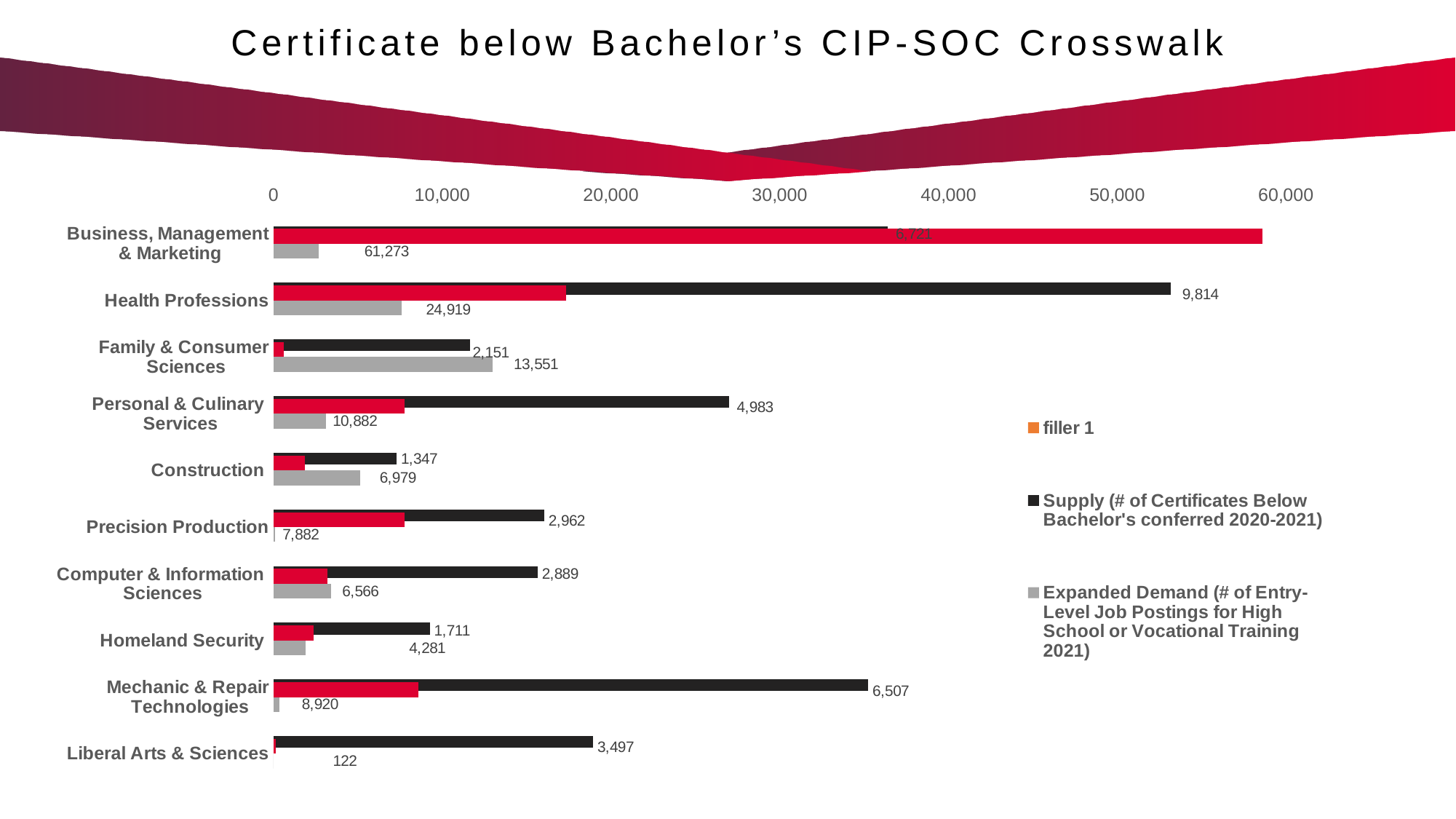
What is the difference between the labelled Supply values for Health Professions (9,814) and Business, Management & Marketing (6,721)? 3,093 How many categories are listed on the vertical axis of the chart? 10 Which category has the lowest labelled Supply value? Construction How many series does the chart's legend list? 3 What data label is shown on the Supply bar for Business, Management & Marketing? 6,721 What data label is shown on the Supply bar for Mechanic & Repair Technologies? 6,507 Which category has the highest labelled Supply value? Health Professions What data label is shown on the Supply bar for Health Professions? 9,814 What data label is shown on the Expanded Demand bar for Liberal Arts & Sciences? 122 What data label is shown on the Expanded Demand bar for Family & Consumer Sciences? 13,551 What kind of chart is shown on the slide? bar chart What is the title of the chart? Certificate below Bachelor's CIP-SOC Crosswalk